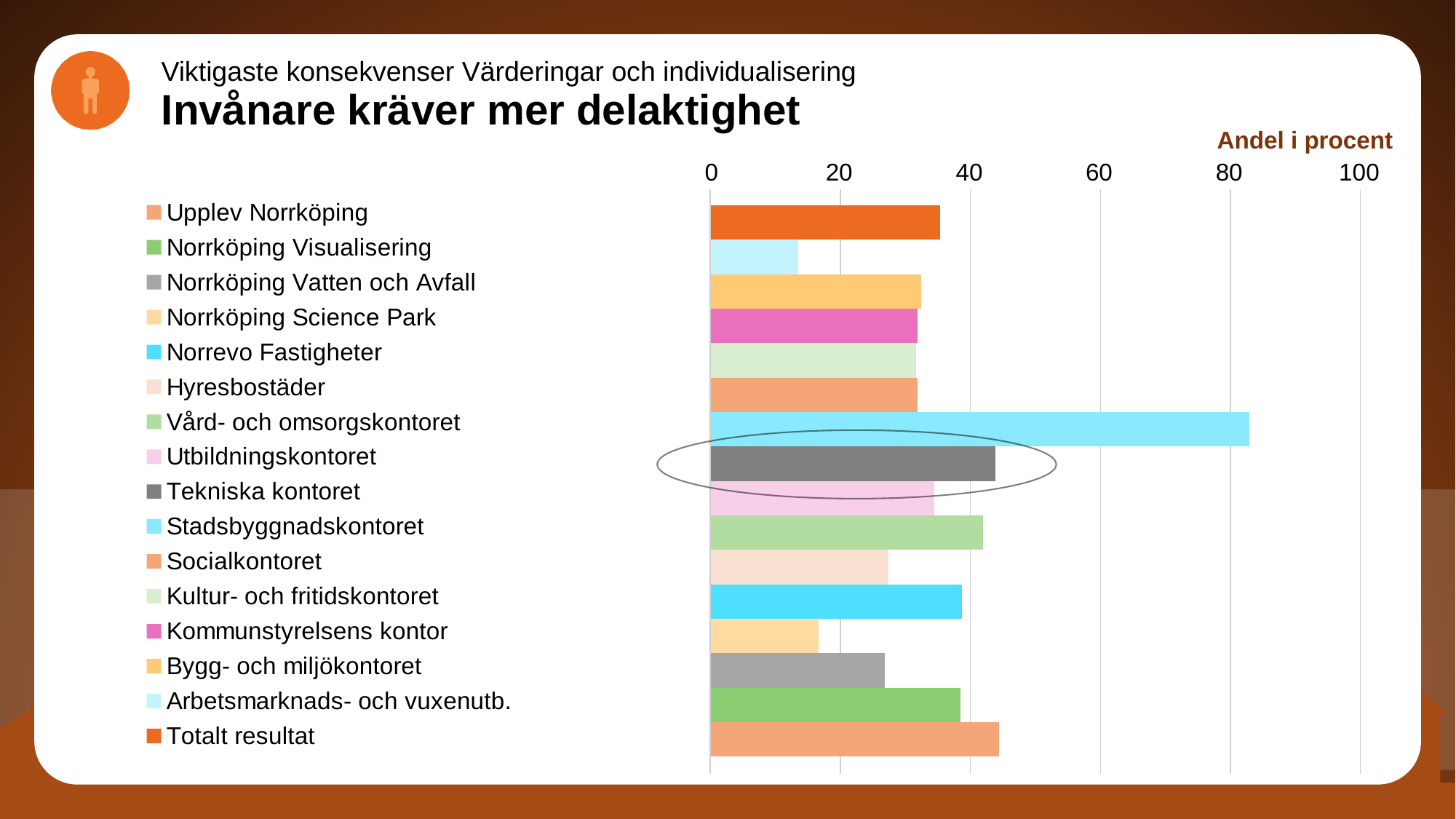
What kind of chart is shown on the slide? bar chart Which category has the lowest value in the chart? Arbetsmarknads- och vuxenutb. Is the value for Stadsbyggnadskontoret greater or less than 60? greater Which is larger, the value for Norrevo Fastigheter or the value for Hyresbostäder? Norrevo Fastigheter Which is larger, the value for Stadsbyggnadskontoret or the value for Tekniska kontoret? Stadsbyggnadskontoret Is the value for Totalt resultat greater or less than 40? less Is the value for Hyresbostäder greater or less than 20? greater Which category has the highest value in the chart? Stadsbyggnadskontoret What label is shown above the horizontal axis of the chart? Andel i procent How many bars (categories) does the chart show? 16